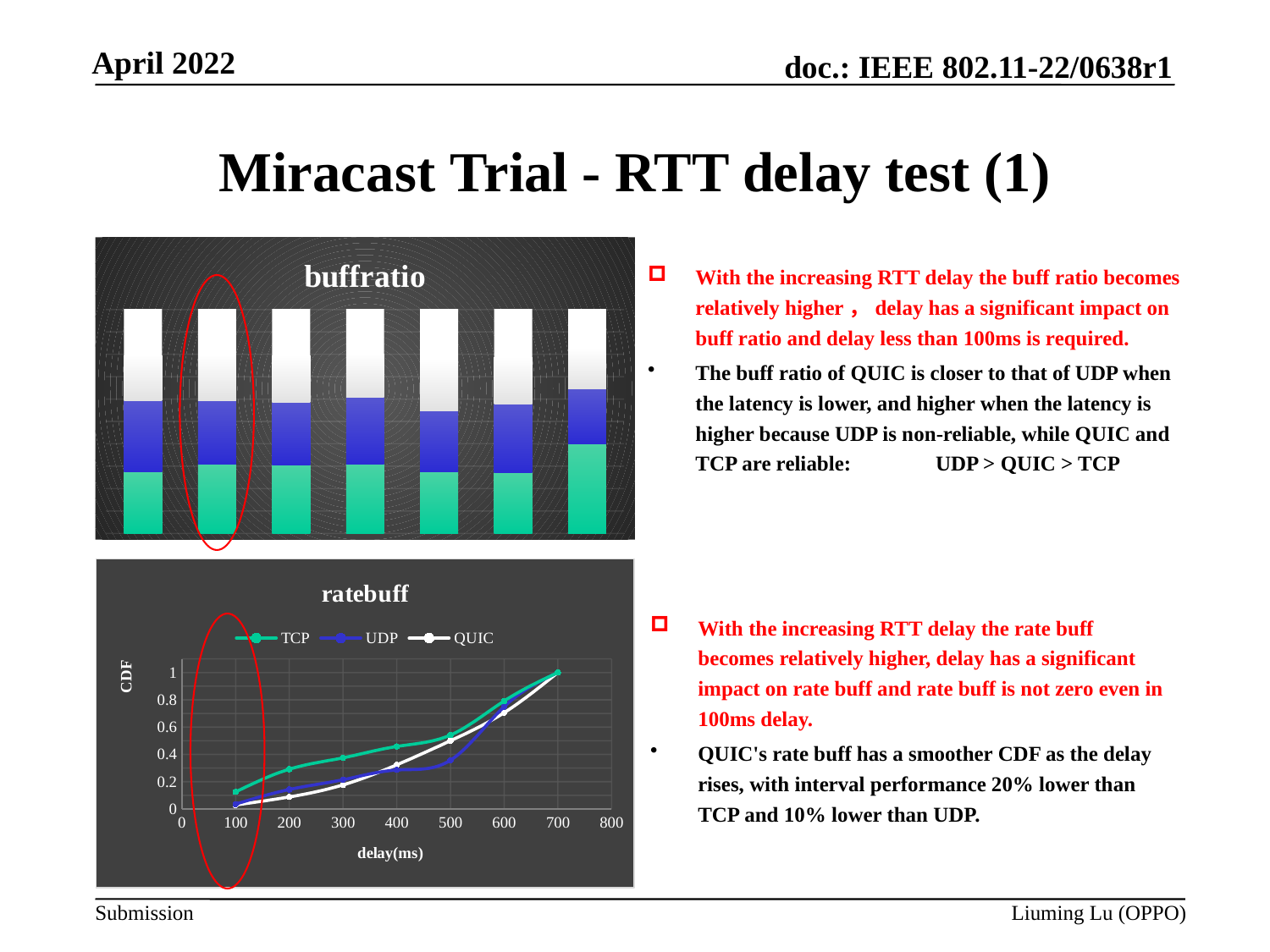
What kind of chart is the 'ratebuff' chart? line chart How many series does the legend of the 'ratebuff' chart list? 3 Which series are listed in the legend of the 'ratebuff' chart? TCP, UDP, QUIC In the 'ratebuff' chart, is the CDF value for TCP at 500 ms greater or less than 0.4? greater How many bars are shown in the 'buffratio' chart? 7 In the 'ratebuff' chart, what CDF value does the TCP series reach at a delay of 700 ms? 1 In the 'ratebuff' chart, do the CDF values of the QUIC series rise or fall as delay increases? rise In the 'ratebuff' chart, at a delay of 300 ms, which series has the larger CDF value, TCP or UDP? TCP In the 'ratebuff' chart, what is the label of the x axis? delay(ms) In the 'ratebuff' chart, is the CDF value for UDP at 400 ms greater or less than 0.4? less What kind of chart is the 'buffratio' chart? stacked bar chart In the 'ratebuff' chart, which series has the highest CDF value at a delay of 200 ms? TCP